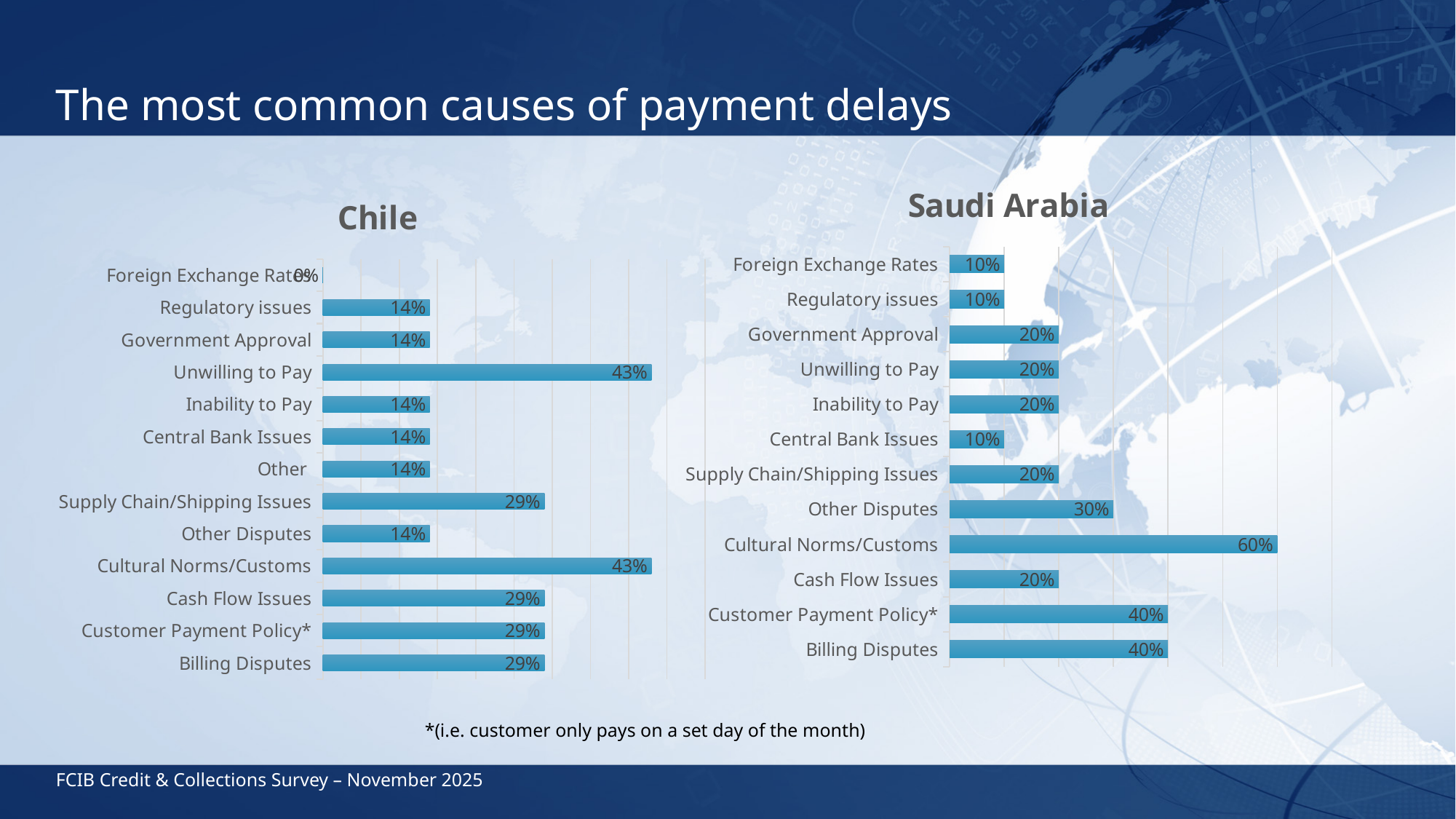
How many categories are shown in the Chile chart? 13 In the Chile chart, what is the value for Unwilling to Pay? 43% In the Saudi Arabia chart, what is the value for Other Disputes? 30% In the Saudi Arabia chart, what is the value for Cultural Norms/Customs? 60% In the Chile chart, what is the value for Supply Chain/Shipping Issues? 29% In the Chile chart, which category has the lowest value? Foreign Exchange Rates In the Saudi Arabia chart, which is larger: Customer Payment Policy* or Cash Flow Issues? Customer Payment Policy* How many categories are shown in the Saudi Arabia chart? 12 In the Saudi Arabia chart, what is the difference between Cultural Norms/Customs and Billing Disputes? 20% In the Saudi Arabia chart, which category has the highest value? Cultural Norms/Customs What type of chart is the Chile chart? Bar chart In the Chile chart, what is the difference between Unwilling to Pay and Cash Flow Issues? 14%